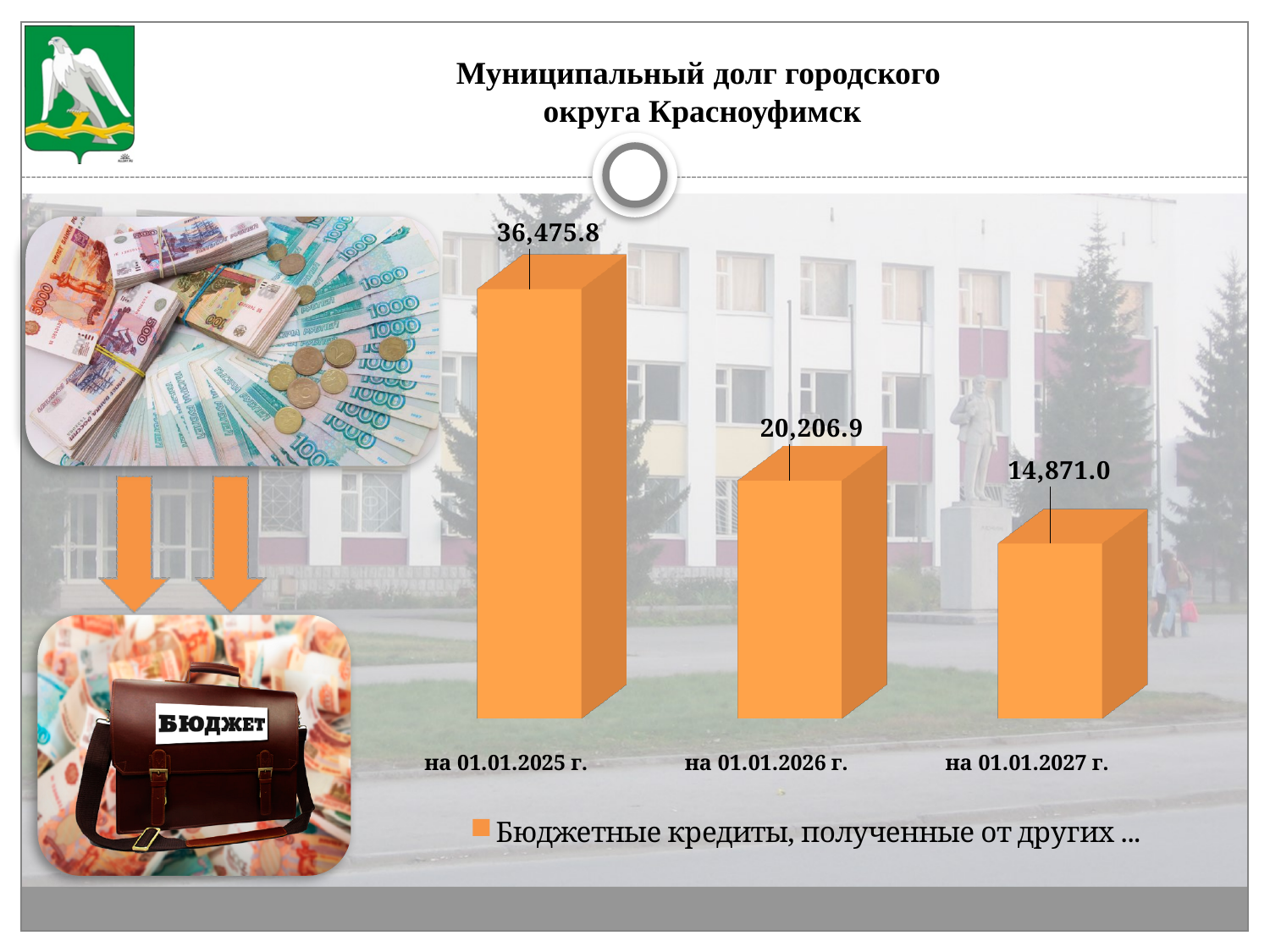
What is the difference between the values for на 01.01.2026 г. and на 01.01.2027 г.? 5,335.9 What is the value for на 01.01.2025 г.? 36,475.8 How many bars are shown in the chart? 3 What is the value for на 01.01.2027 г.? 14,871.0 Which is larger, the value for на 01.01.2026 г. or на 01.01.2027 г.? на 01.01.2026 г. Which date has the highest value? на 01.01.2025 г. What is the value for на 01.01.2026 г.? 20,206.9 What is the title of the chart? Муниципальный долг городского округа Красноуфимск Which date has the lowest value? на 01.01.2027 г. What is the difference between the values for на 01.01.2025 г. and на 01.01.2026 г.? 16,268.9 What kind of chart is shown on the slide? Bar chart Do the values rise or fall from на 01.01.2025 г. to на 01.01.2027 г.? Fall